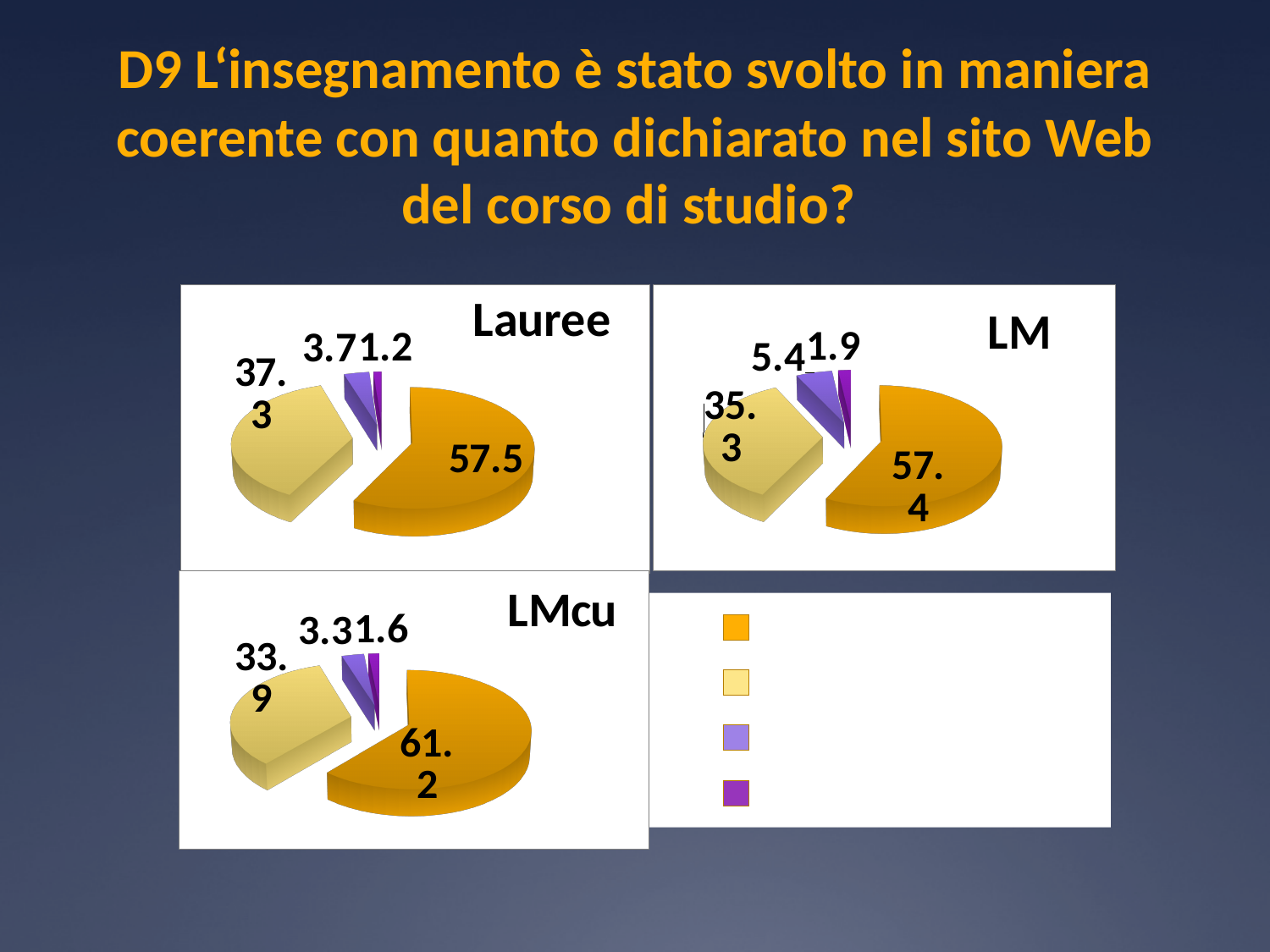
In the LM chart, what value is shown for the light purple slice? 5.4 In the Lauree chart, what is the difference between the orange slice (57.5) and the yellow slice (37.3)? 20.2 Which chart has the larger orange slice value, Lauree or LMcu? LMcu In the Lauree chart, what value is shown for the largest (orange) slice? 57.5 How many slices does the LM pie chart have? 4 What type of chart is used for the Lauree, LM and LMcu data? Pie chart In the LM chart, what is the largest value shown? 57.4 In the LMcu chart, what value is shown for the largest (orange) slice? 61.2 In the Lauree chart, what is the smallest value shown? 1.2 In the LM chart, what value is shown for the light yellow slice? 35.3 In the LMcu chart, which slice has the smallest value? The dark purple slice (1.6) How many pie charts are shown on the slide? 3